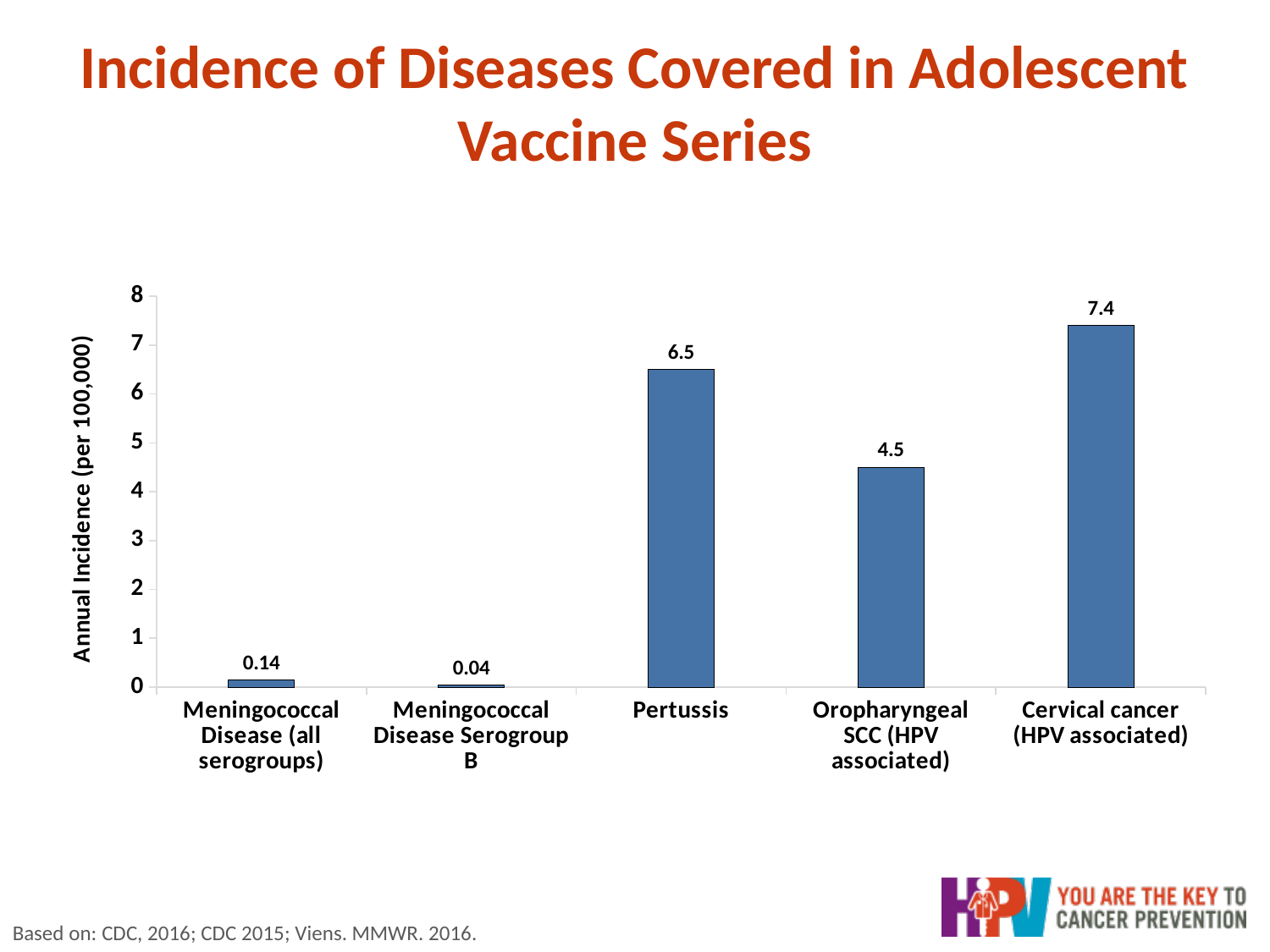
What is the label of the vertical axis? Annual Incidence (per 100,000) What is the annual incidence per 100,000 for Oropharyngeal SCC (HPV associated)? 4.5 Which disease has the highest annual incidence? Cervical cancer (HPV associated) Which disease has the lowest annual incidence? Meningococcal Disease Serogroup B What is the annual incidence per 100,000 for Meningococcal Disease Serogroup B? 0.04 What is the annual incidence per 100,000 for Cervical cancer (HPV associated)? 7.4 How many diseases are shown on the chart? 5 What kind of chart is shown on the slide? Bar chart What is the difference in annual incidence between Meningococcal Disease (all serogroups) and Meningococcal Disease Serogroup B? 0.1 What is the annual incidence per 100,000 for Pertussis? 6.5 Which has a higher annual incidence, Pertussis or Oropharyngeal SCC (HPV associated)? Pertussis What is the difference in annual incidence between Cervical cancer (HPV associated) and Pertussis? 0.9